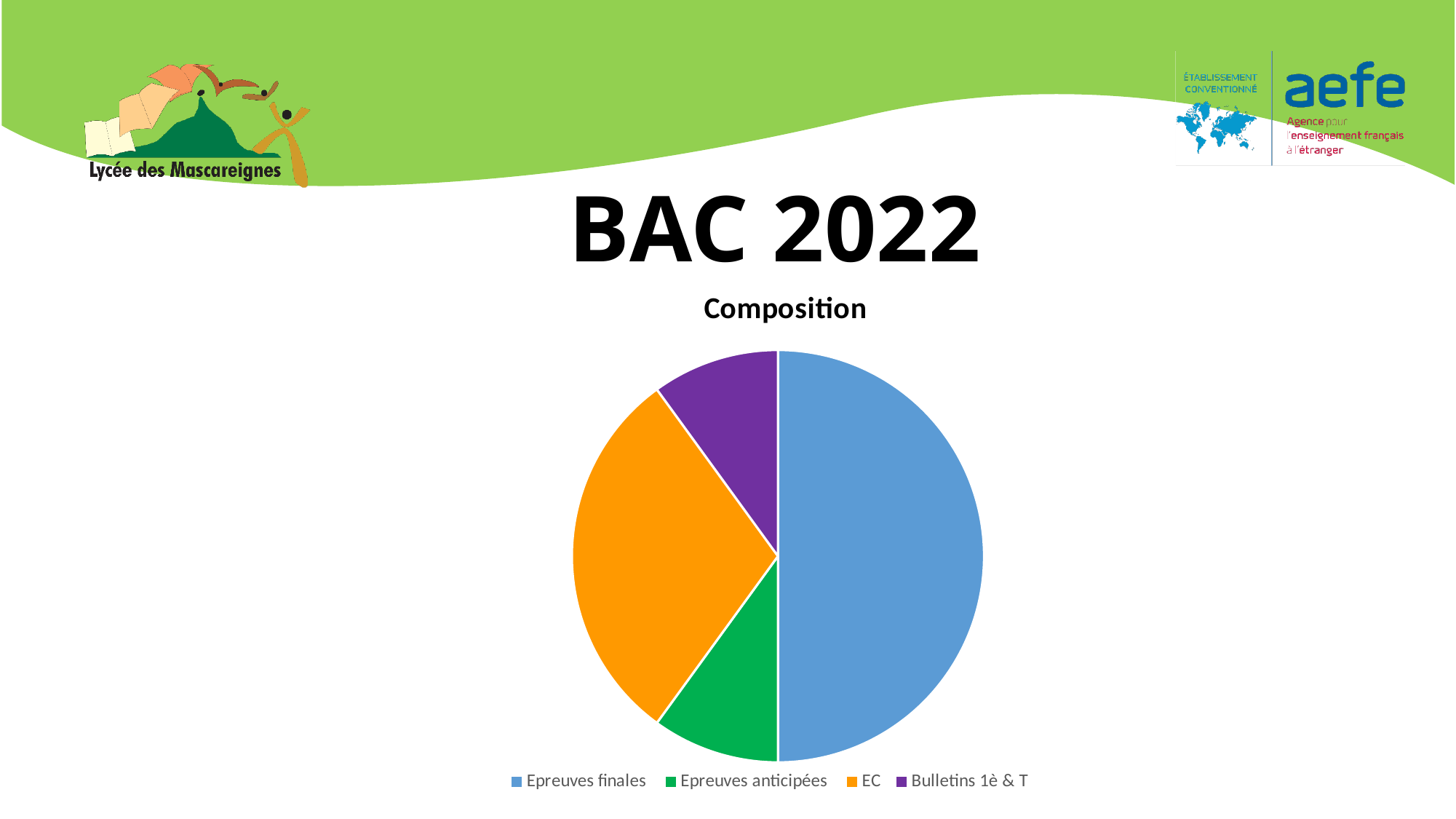
What kind of chart is shown on the slide? pie chart What is the title of the chart? Composition Which is larger, the slice for Epreuves finales or the slice for EC? Epreuves finales How many slices does the pie chart have? 4 How many entries does the legend list? 4 Which is larger, the slice for EC or the slice for Bulletins 1è & T? EC What colour is the slice for EC? orange Which is larger, the slice for EC or the slice for Epreuves anticipées? EC Which category has the largest slice of the pie? Epreuves finales